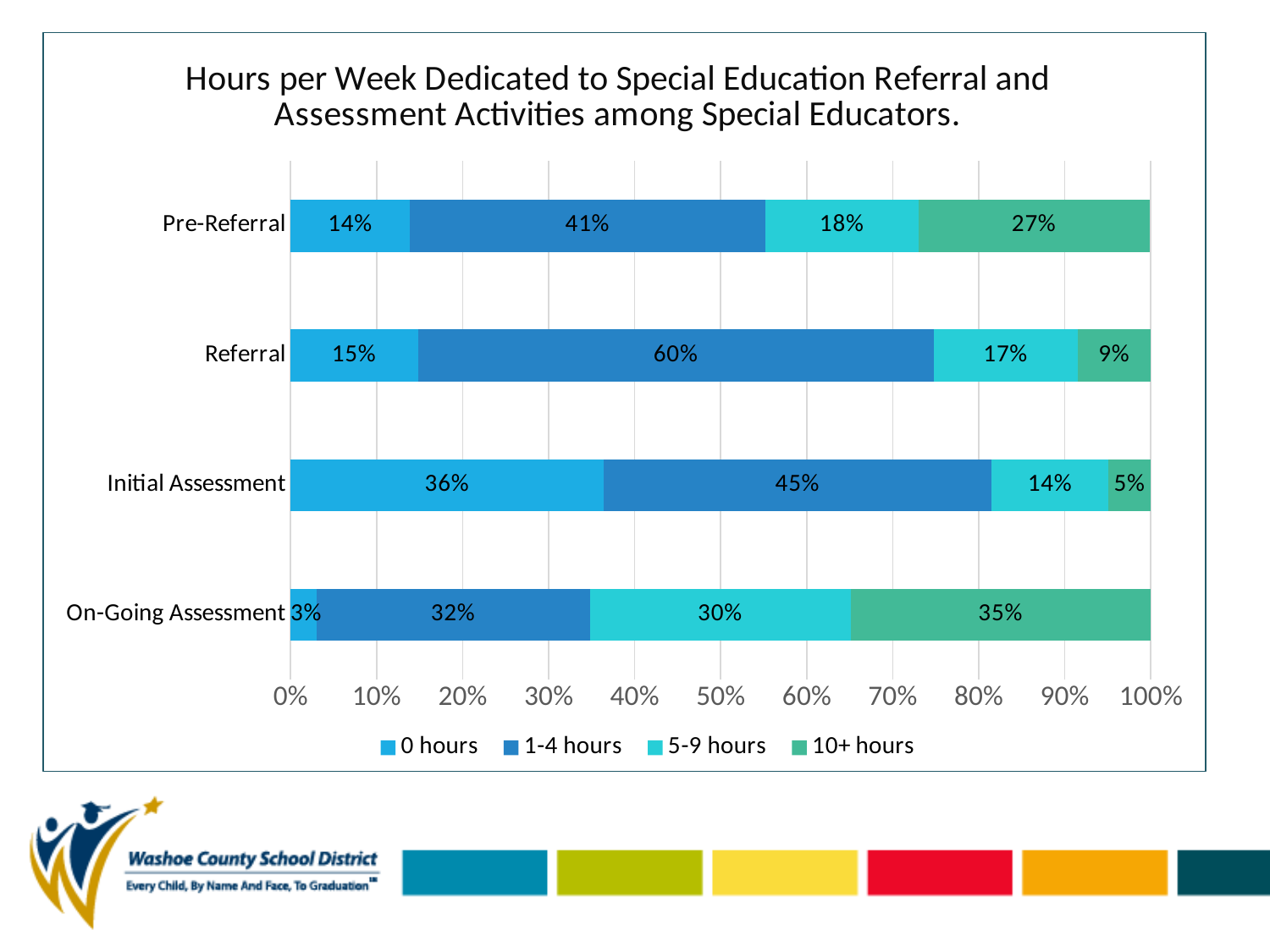
Which activity has the lowest percentage in the 0 hours category? On-Going Assessment What percentage of special educators reported 0 hours per week on Initial Assessment? 36% How many activity categories are shown on the chart? 4 What is the total of the stacked bar for Initial Assessment? 100% What is the difference between the 1-4 hours percentages for Referral and Pre-Referral? 19% Which is larger: the 5-9 hours share for On-Going Assessment or for Pre-Referral? On-Going Assessment What percentage of special educators reported 10+ hours per week on On-Going Assessment? 35% How many series does the legend list? 4 What percentage of special educators reported 1-4 hours per week on Referral activities? 60% What kind of chart is shown on the slide? Stacked bar chart Which activity has the highest percentage in the 10+ hours category? On-Going Assessment What is the title of the chart? Hours per Week Dedicated to Special Education Referral and Assessment Activities among Special Educators.